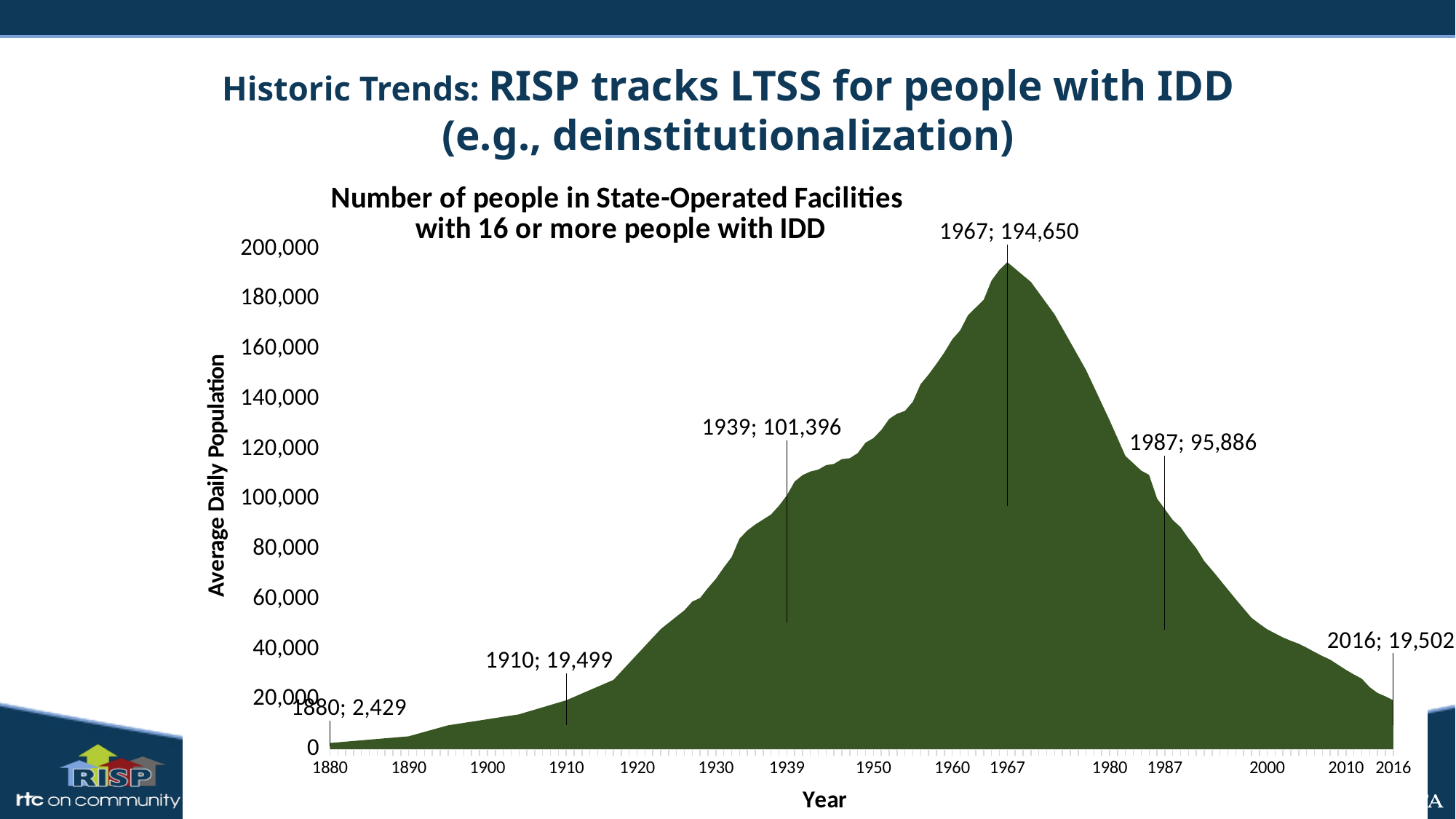
What value is labeled for the year 2016? 19,502 In which labeled year was the average daily population highest? 1967 What is the difference between the labeled values for 1967 and 1987? 98,764 What value is labeled for the year 1987? 95,886 Which labeled year has the lowest average daily population? 1880 Does the average daily population rise or fall between 1967 and 2016? Fall What kind of chart is shown on the slide? Area chart What was the average daily population in state-operated facilities in 1967? 194,650 What is the title of the vertical axis? Average Daily Population What is the difference between the labeled values for 1939 and 1910? 81,897 Is the value for 1950 greater or less than 100,000? greater What value is labeled for the year 1880? 2,429